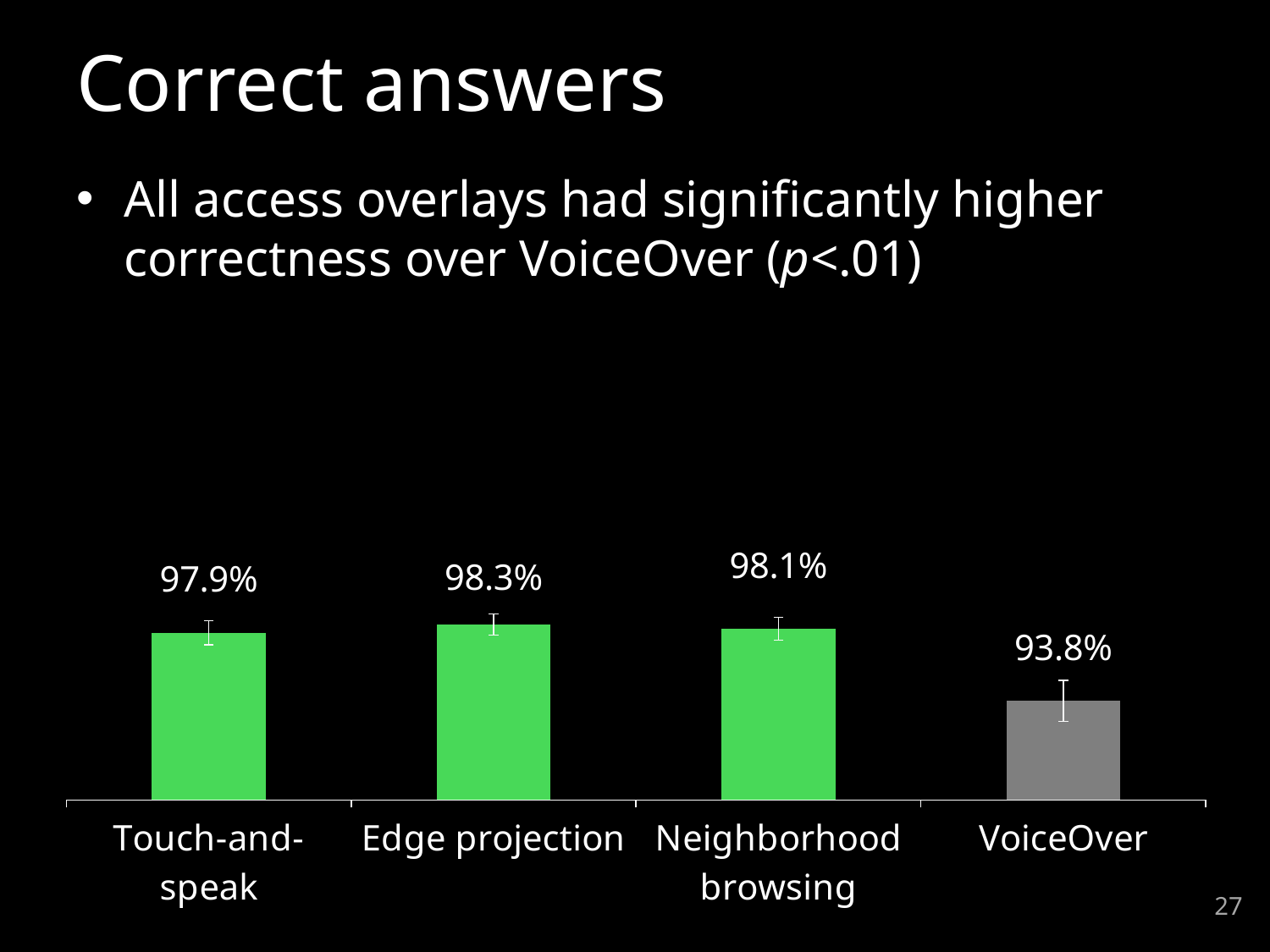
What is the difference between the values for Edge projection and VoiceOver? 4.5% What is the value for VoiceOver? 93.8% What kind of chart is shown on the slide? Bar chart How many categories are shown in the chart? 4 Which category has the highest value? Edge projection What is the value for Neighborhood browsing? 98.1% What is the value for Edge projection? 98.3% What is the value for Touch-and-speak? 97.9% Which is larger, the value for Neighborhood browsing or the value for VoiceOver? Neighborhood browsing Which category has the lowest value? VoiceOver What is the difference between the values for Touch-and-speak and VoiceOver? 4.1% Which bar is coloured differently from the others? VoiceOver